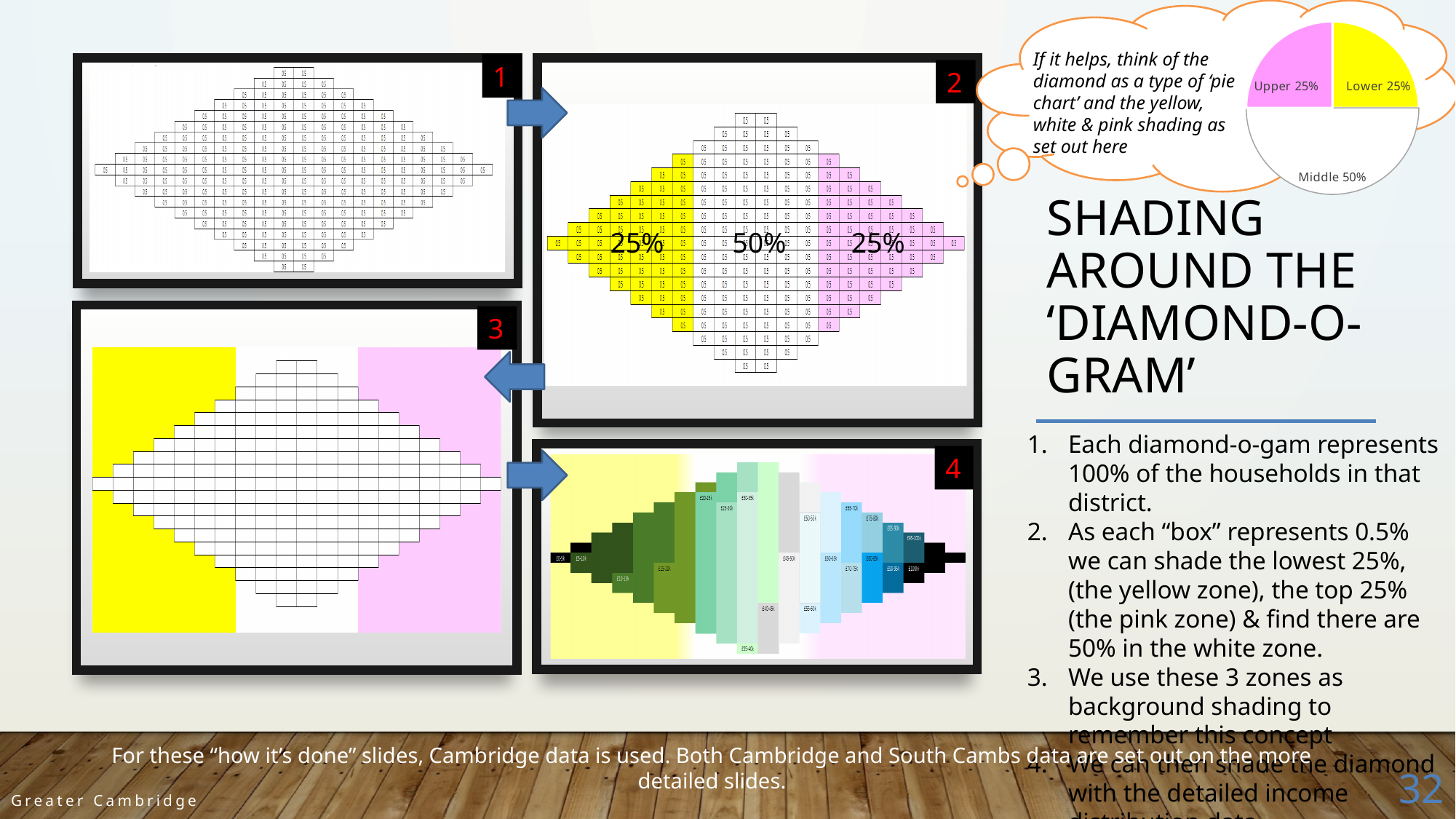
What kind of chart is shown in the thought bubble at the top right of the slide? pie chart In the diamond-o-gram labelled 2, what percentage is printed over the white middle zone? 50% In the diamond-o-gram labelled 2, what percentage is printed over the yellow zone? 25% In the pie chart in the thought bubble, what is the difference between the Middle share and the Lower share? 25% In the pie chart in the thought bubble, what share does the Upper slice represent? 25% In the pie chart in the thought bubble, how many slices are there? 3 In the pie chart in the thought bubble, what colour is the Lower 25% slice? yellow In the pie chart in the thought bubble, which slice is the largest? Middle 50% In the pie chart in the thought bubble, what colour is the Upper 25% slice? pink In the pie chart in the thought bubble, which is larger, the Middle slice or the Upper slice? Middle In the pie chart in the thought bubble, what share does the Lower slice represent? 25% In the pie chart in the thought bubble, what share does the Middle slice represent? 50%